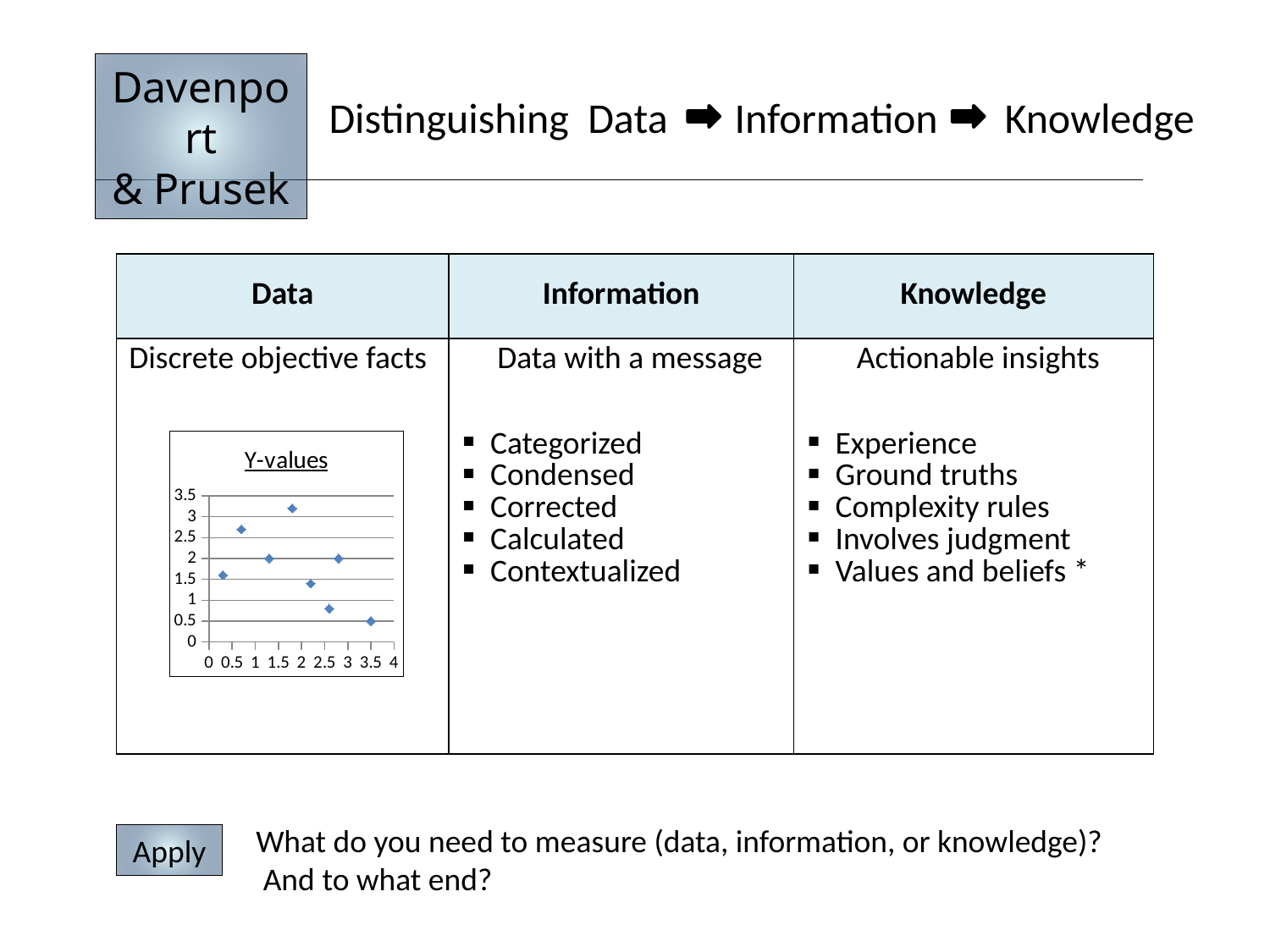
In the Y-values chart, is the point plotted furthest to the left (near x = 0.3) greater or less than 1? greater What is the maximum value shown on the y axis of the Y-values chart? 3.5 What kind of chart is shown in the Data column of the table? scatter chart How many data points are plotted in the Y-values chart? 8 In the Y-values chart, which is larger: the point near x = 1.8 or the point near x = 3.5? the point near x = 1.8 What is the title of the chart in the Data column? Y-values In the Y-values chart, is the point plotted furthest to the right (near x = 3.5) greater or less than 1? less In the Y-values chart, is the highest plotted point greater or less than 3? greater